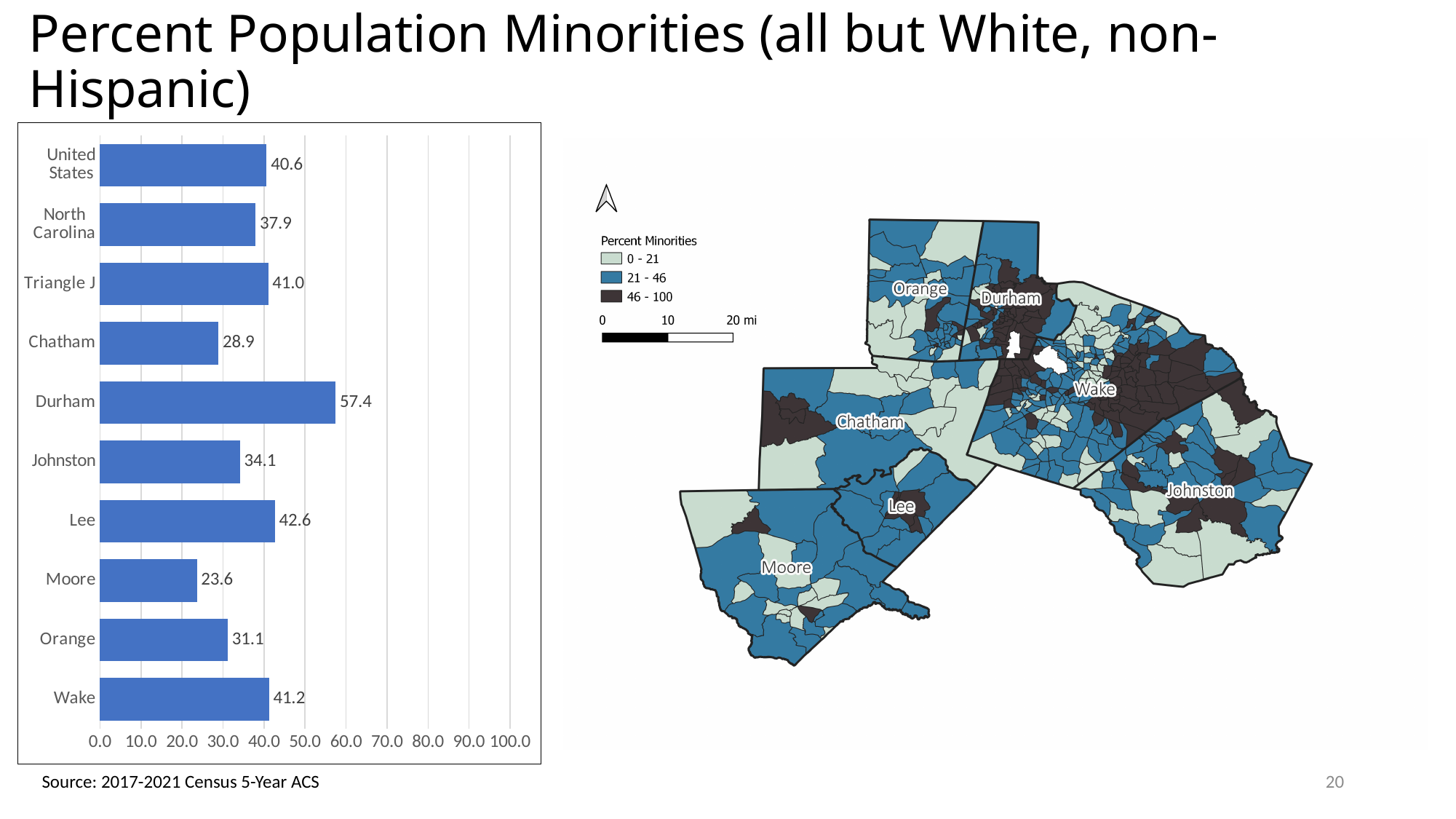
How many categories are shown in the bar chart? 10 Which category has the highest value in the bar chart? Durham What kind of chart is shown on the left of the slide? bar chart What is the value for Durham in the bar chart? 57.4 What is the value for Moore in the bar chart? 23.6 Is the value for Johnston in the bar chart greater or less than 30.0? greater Which category has the lowest value in the bar chart? Moore What is the value for North Carolina in the bar chart? 37.9 What is the difference between the values for Durham and Chatham in the bar chart? 28.5 What is the highest value shown on the x axis of the bar chart? 100.0 Which is larger in the bar chart, the value for Lee or the value for Wake? Lee What is the difference between the values for United States and Orange in the bar chart? 9.5